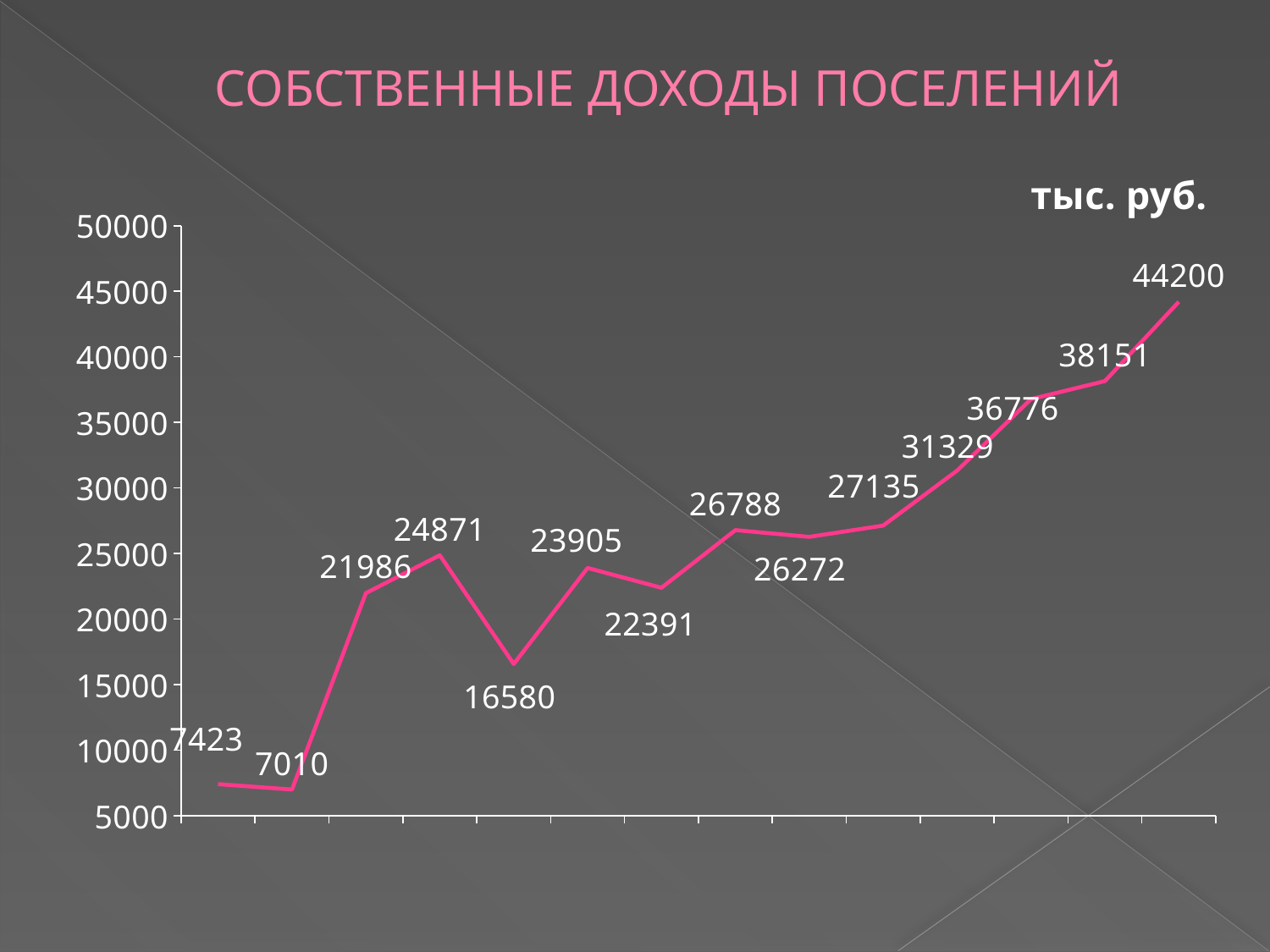
Is the value of the last point on the line greater or less than 40000? greater What is the difference between the last point (44200) and the first point (7423)? 36777 What is the difference between the highest value (44200) and the lowest value (7010)? 37190 What unit is indicated above the chart? тыс. руб. Overall, do the values rise or fall from left to right along the line? rise What is the highest value shown on the chart? 44200 What is the lowest value shown on the chart? 7010 What is the title of the chart? СОБСТВЕННЫЕ ДОХОДЫ ПОСЕЛЕНИЙ What is the value of the first (leftmost) point on the line? 7423 How many data points are plotted on the line? 14 What type of chart is shown on the slide? line chart What is the value of the last (rightmost) point on the line? 44200